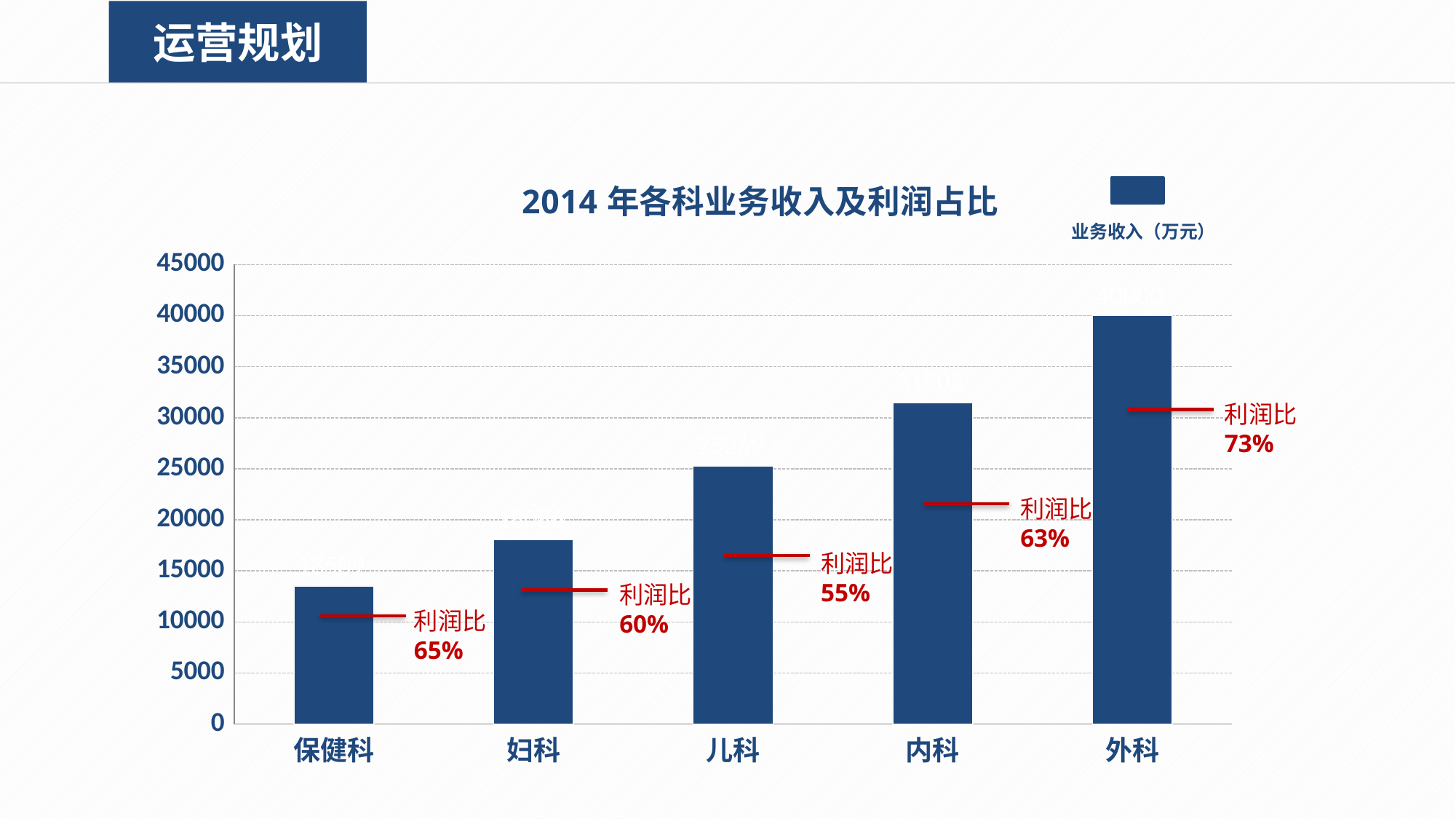
Which department has the highest 业务收入 bar? 外科 What is the 利润比 shown for 儿科? 55% How many departments (categories) are shown on the x axis? 5 What is the title of the chart? 2014 年各科业务收入及利润占比 What series does the legend list? 业务收入（万元） Is the 业务收入 value for 内科 greater or less than 30000? greater Which department has the lowest 业务收入 bar? 保健科 Do the 业务收入 bars rise or fall from 保健科 to 外科 along the x axis? rise What is the 利润比 shown for 保健科? 65% Is the 业务收入 value for 妇科 greater or less than 20000? less What is the 利润比 shown for 外科? 73% What kind of chart is shown on the slide? bar chart